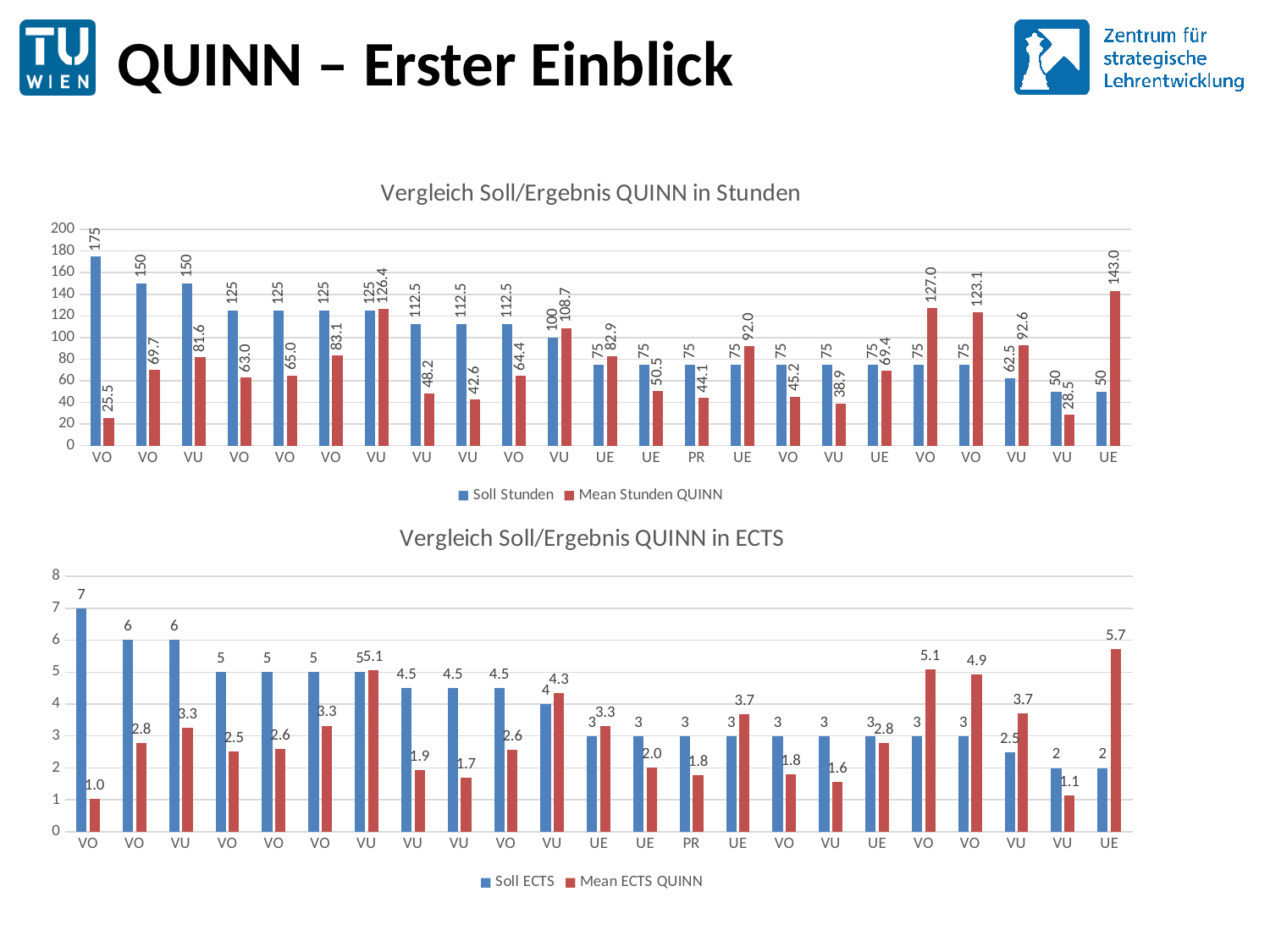
In the bottom chart 'Vergleich Soll/Ergebnis QUINN in ECTS', which is larger for the PR category, Soll ECTS or Mean ECTS QUINN? Soll ECTS In the bottom chart 'Vergleich Soll/Ergebnis QUINN in ECTS', what is the Mean ECTS QUINN value for the PR category? 1.8 In the bottom chart 'Vergleich Soll/Ergebnis QUINN in ECTS', what is the highest Mean ECTS QUINN value shown? 5.7 How many categories are shown on the x axis of the bottom chart 'Vergleich Soll/Ergebnis QUINN in ECTS'? 23 In the top chart 'Vergleich Soll/Ergebnis QUINN in Stunden', what is the Mean Stunden QUINN value for the PR category? 44.1 What kind of chart is the top chart, 'Vergleich Soll/Ergebnis QUINN in Stunden'? bar chart What are the two legend entries of the bottom chart 'Vergleich Soll/Ergebnis QUINN in ECTS'? Soll ECTS and Mean ECTS QUINN In the top chart 'Vergleich Soll/Ergebnis QUINN in Stunden', what is the highest Mean Stunden QUINN value shown? 143.0 In the top chart 'Vergleich Soll/Ergebnis QUINN in Stunden', what is the difference between Soll Stunden and Mean Stunden QUINN for the PR category? 30.9 In the top chart 'Vergleich Soll/Ergebnis QUINN in Stunden', what is the Soll Stunden value for the leftmost category? 175 How many series does the legend of the top chart 'Vergleich Soll/Ergebnis QUINN in Stunden' list? 2 In the top chart 'Vergleich Soll/Ergebnis QUINN in Stunden', what is the lowest Mean Stunden QUINN value shown? 25.5